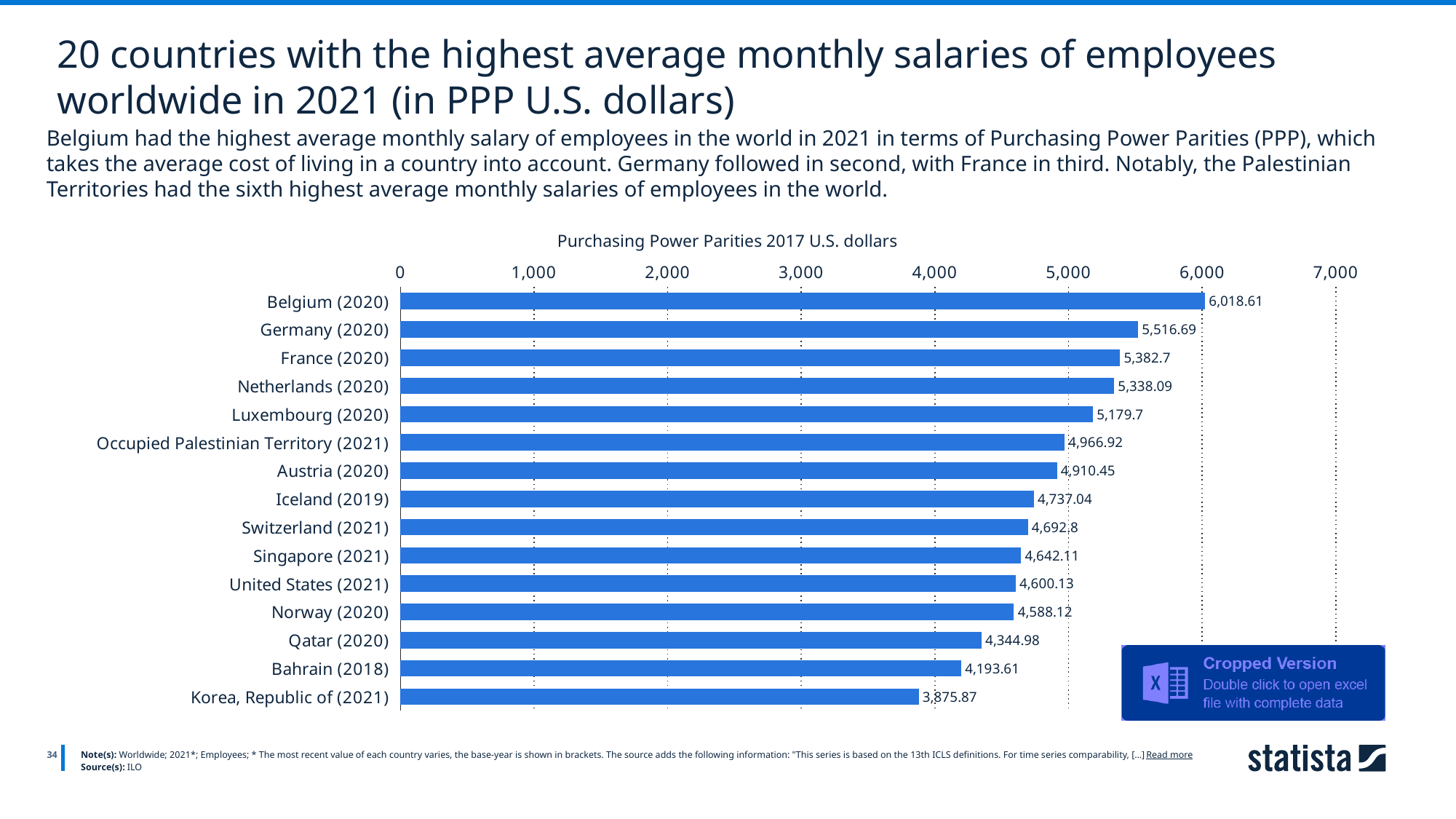
How many countries are shown as bars in the chart? 15 What type of chart is shown on the slide? bar chart What is the difference between the values for Belgium (2020) and Germany (2020)? 501.92 Which country has the lowest value shown in the chart? Korea, Republic of (2021) What value is shown for United States (2021)? 4,600.13 What value is shown for Korea, Republic of (2021)? 3,875.87 What value is shown for Occupied Palestinian Territory (2021)? 4,966.92 What is the average monthly salary shown for Belgium (2020)? 6,018.61 What is the difference between the values for Qatar (2020) and Bahrain (2018)? 151.37 Which is larger, the value for Luxembourg (2020) or the value for Austria (2020)? Luxembourg (2020) Is the value for Iceland (2019) greater or less than 5,000? less Which country has the highest value in the chart? Belgium (2020)